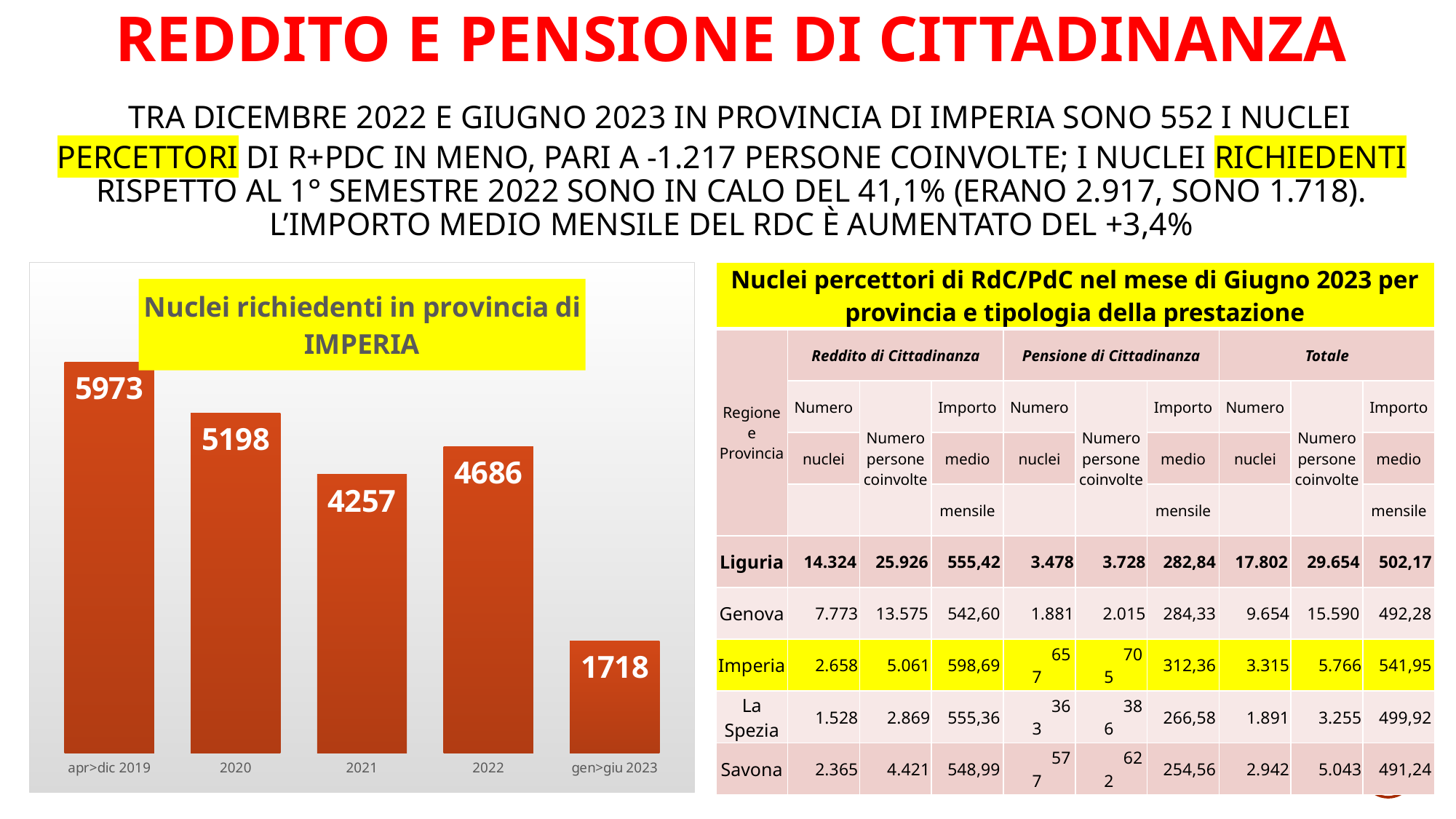
What is the difference between the values for apr>dic 2019 and 2020 in the chart 'Nuclei richiedenti in provincia di IMPERIA'? 775 What is the value for gen>giu 2023 in the chart 'Nuclei richiedenti in provincia di IMPERIA'? 1718 What type of chart is 'Nuclei richiedenti in provincia di IMPERIA'? bar chart What is the difference between the values for 2022 and gen>giu 2023 in the chart 'Nuclei richiedenti in provincia di IMPERIA'? 2968 What is the value for 2020 in the chart 'Nuclei richiedenti in provincia di IMPERIA'? 5198 In the chart 'Nuclei richiedenti in provincia di IMPERIA', which is larger: the value for 2021 or the value for 2022? 2022 How many bars are shown in the chart 'Nuclei richiedenti in provincia di IMPERIA'? 5 What is the title of the bar chart on the left of the slide? Nuclei richiedenti in provincia di IMPERIA What is the value for 2021 in the chart 'Nuclei richiedenti in provincia di IMPERIA'? 4257 In the chart 'Nuclei richiedenti in provincia di IMPERIA', does the value rise or fall from 2021 to 2022? rise Which period has the lowest value in the chart 'Nuclei richiedenti in provincia di IMPERIA'? gen>giu 2023 Which period has the highest value in the chart 'Nuclei richiedenti in provincia di IMPERIA'? apr>dic 2019